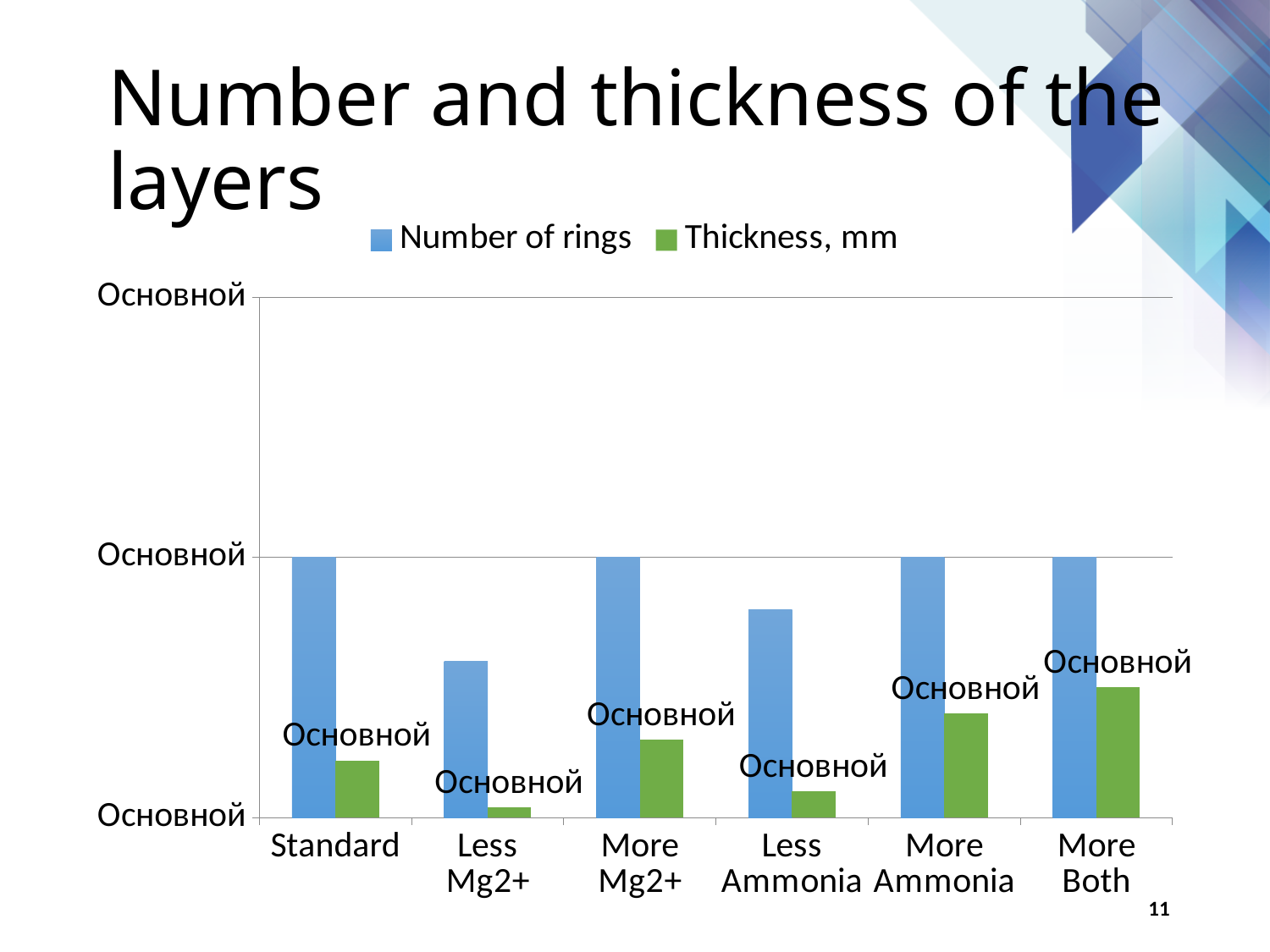
Which category has the lowest value for Number of rings? Less Mg2+ Which has the larger Thickness, mm value, More Ammonia or More Both? More Both How many series does the legend list? 2 Which category has the highest value for Thickness, mm? More Both Which has the larger Number of rings value, Less Mg2+ or Less Ammonia? Less Ammonia Which has the larger Thickness, mm value, Less Ammonia or Standard? Standard What kind of chart is shown on the slide? Bar chart How many categories are shown on the x axis? 6 What is the title of the slide containing the chart? Number and thickness of the layers Which category has the lowest value for Thickness, mm? Less Mg2+ Which series is shown in green in the legend? Thickness, mm